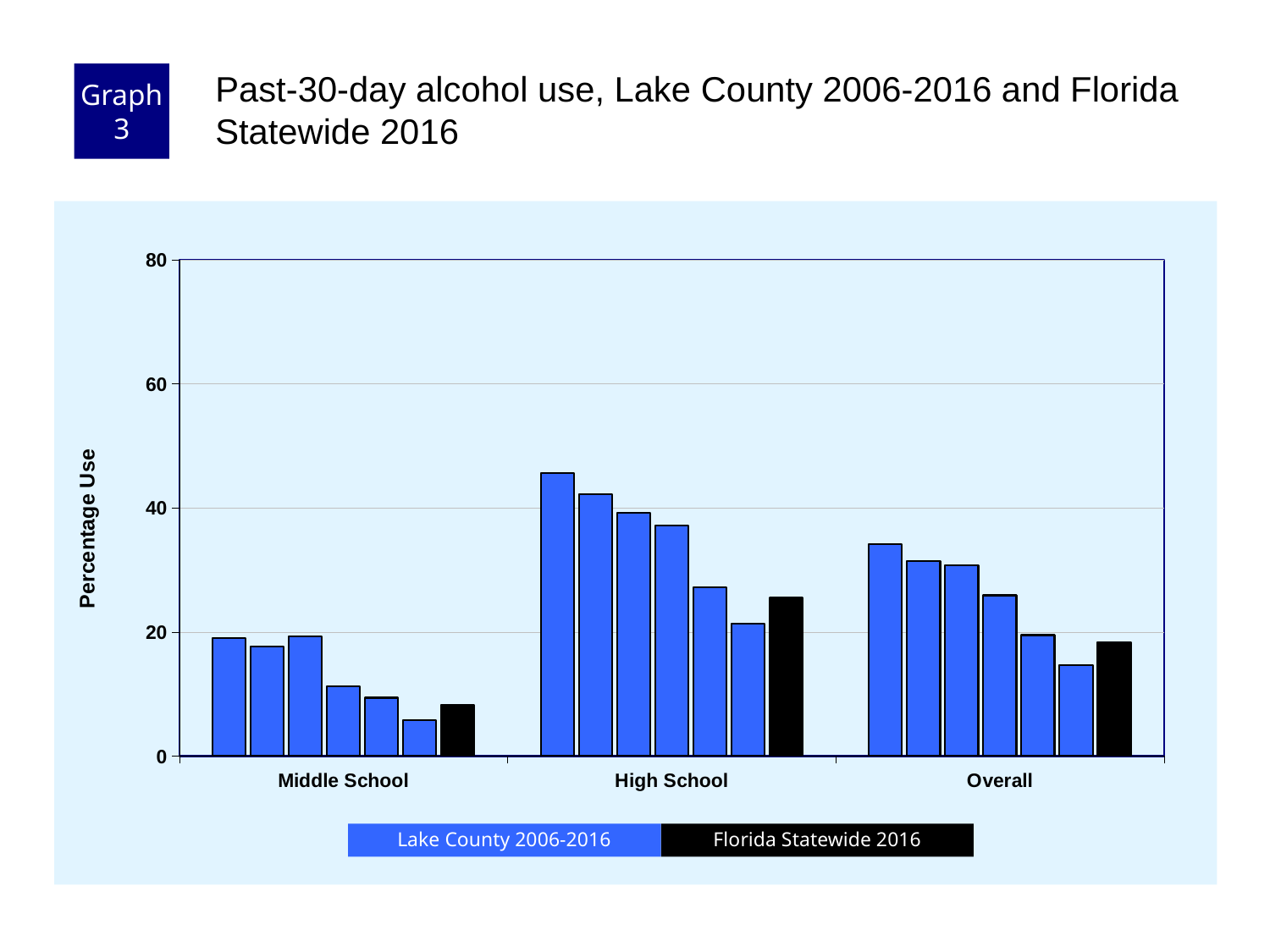
Is the Florida Statewide 2016 value for High School greater or less than 20? greater How many categories are shown along the x axis? 3 Do the Lake County 2006-2016 bars for High School generally rise or fall from left to right? fall How many series does the legend list? 2 Is the Florida Statewide 2016 value for Middle School greater or less than 20? less Which category has the highest Florida Statewide 2016 value? High School Which is larger for Middle School: the first Lake County 2006-2016 bar or the Florida Statewide 2016 bar? the first Lake County 2006-2016 bar Is the tallest Lake County bar for High School greater or less than 40? greater What kind of chart is shown on the slide? bar chart Which category has the lowest Florida Statewide 2016 value? Middle School What is the label on the y axis? Percentage Use